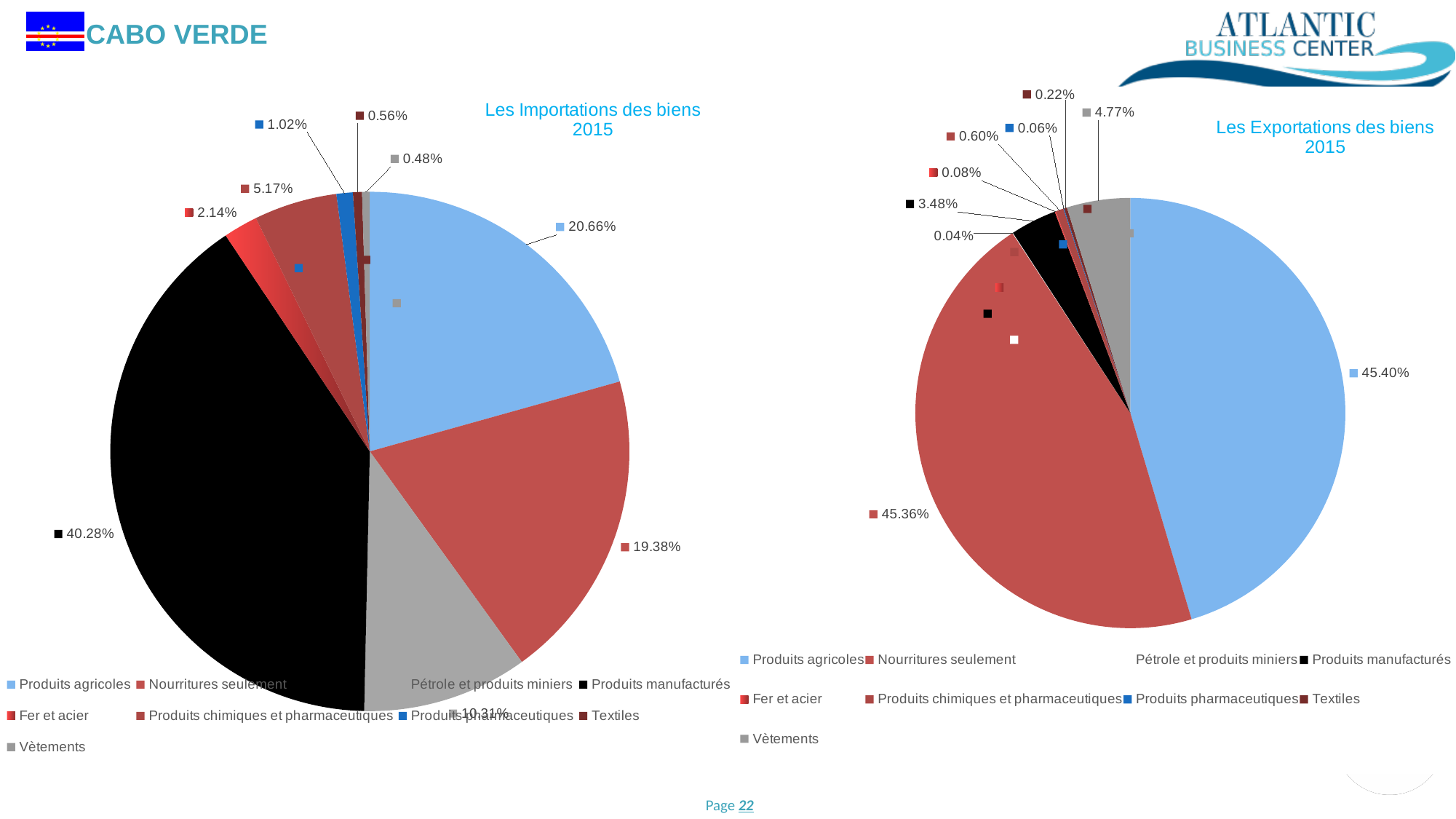
In the 'Les Importations des biens 2015' chart, which is larger: Produits chimiques et pharmaceutiques or Fer et acier? Produits chimiques et pharmaceutiques In the 'Les Importations des biens 2015' chart, which category has the largest slice? Produits manufacturés In the 'Les Exportations des biens 2015' chart, which is larger: Vètements or Produits manufacturés? Vètements In the 'Les Importations des biens 2015' chart, what is the difference between the shares of Produits agricoles and Nourritures seulement? 1.28% In the 'Les Importations des biens 2015' chart, what share do Produits manufacturés have? 40.28% In the 'Les Importations des biens 2015' chart, what share do Produits agricoles have? 20.66% In the 'Les Importations des biens 2015' chart, which category has the smallest slice? Vètements In the 'Les Exportations des biens 2015' chart, what share do Produits agricoles have? 45.40% In the 'Les Exportations des biens 2015' chart, what share do Produits manufacturés have? 3.48% What type of chart is used for 'Les Importations des biens 2015'? Pie chart How many categories does the legend of the 'Les Exportations des biens 2015' chart list? 9 In the 'Les Exportations des biens 2015' chart, what share do Vètements have? 4.77%